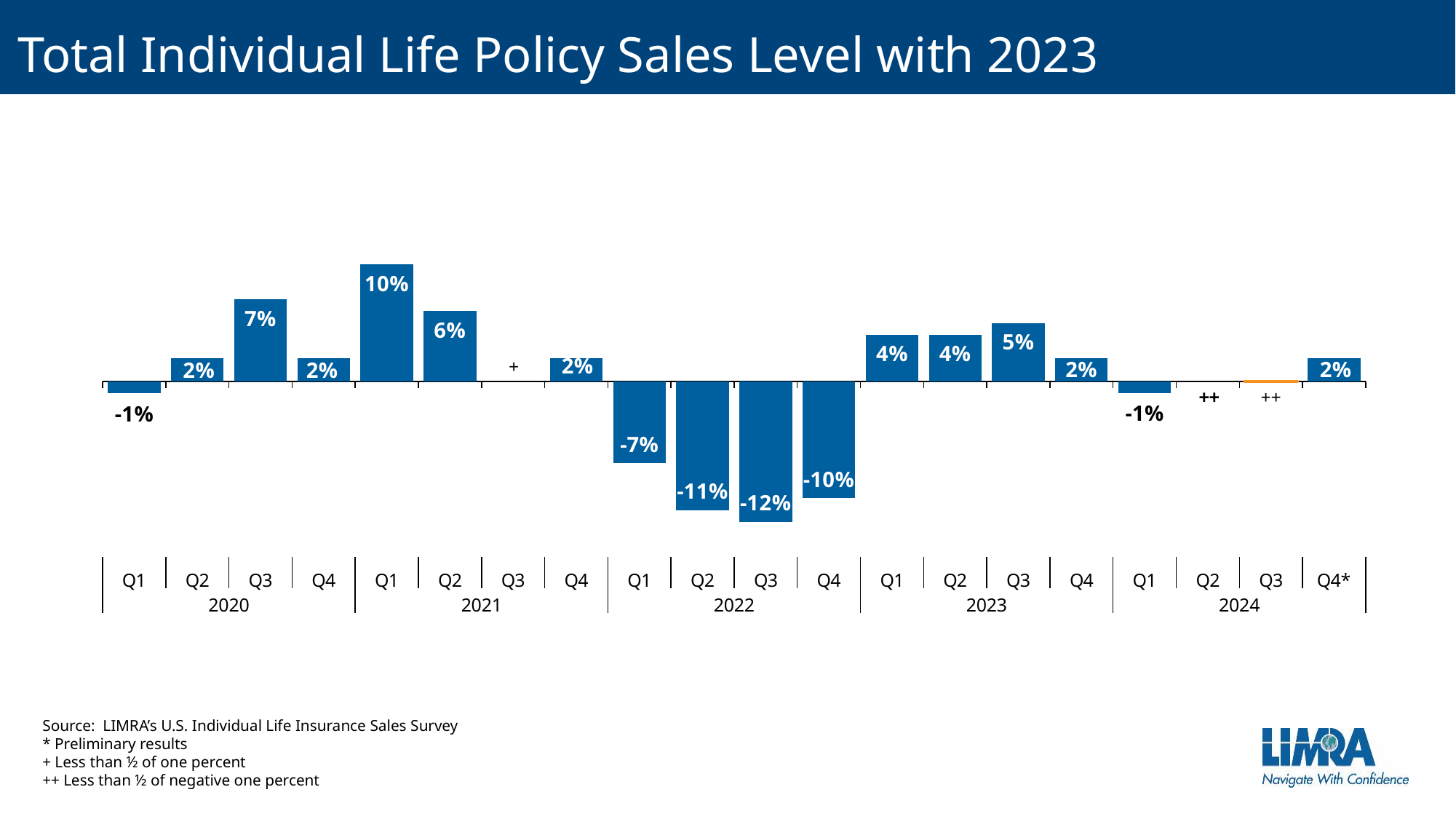
Which quarter has the lowest value? Q3 2022 How many quarters are shown on the x axis? 20 What is the difference between the values for Q2 2022 and Q4 2022? 1% What is the value for Q1 2024? -1% What does the "++" symbol shown for Q2 and Q3 2024 mean according to the footnote? Less than ½ of negative one percent Which is larger, the value for Q3 2020 or the value for Q3 2023? Q3 2020 What kind of chart is shown on the slide? Bar chart Which quarter has the highest value? Q1 2021 What is the difference between the values for Q1 2021 and Q2 2021? 4% What is the value for Q3 2023? 5% What is the value for Q3 2022? -12% What is the value for Q1 2021? 10%